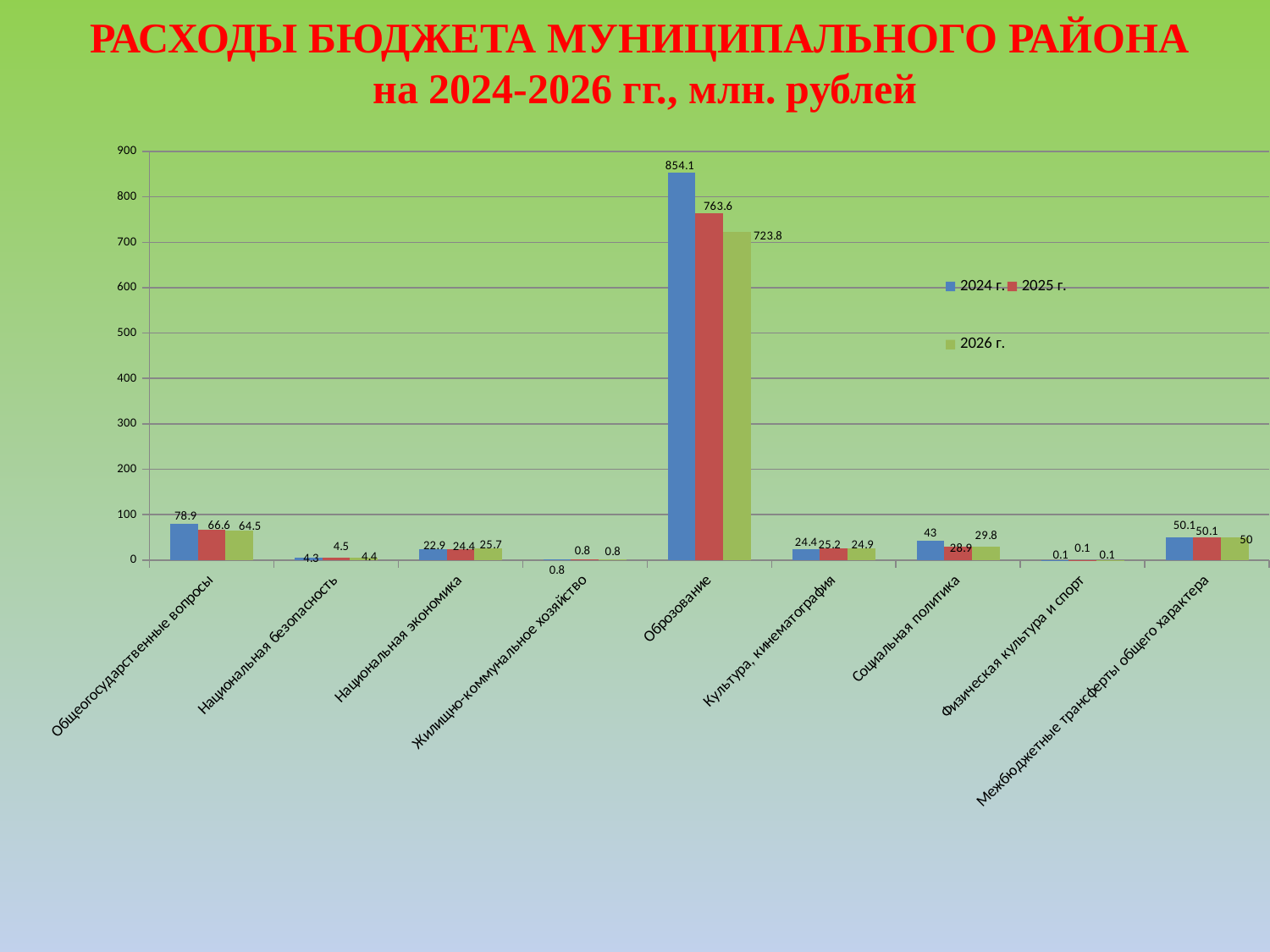
Which category has the highest value in 2025 г.? Образование What is the value for Общегосударственные вопросы in 2026 г.? 64.5 How many categories are shown on the x axis? 9 Which is larger for Национальная экономика: the 2024 г. value or the 2026 г. value? 2026 г. Do the values for Образование rise or fall from 2024 г. to 2026 г.? fall What is the value for Образование in 2024 г.? 854.1 How many series does the legend list? 3 What is the difference between the 2024 г. and 2026 г. values for Образование? 130.3 What is the value for Социальная политика in 2025 г.? 28.9 What type of chart is shown on the slide? bar chart Which category has the lowest value in 2024 г.? Физическая культура и спорт What is the title of the chart? РАСХОДЫ БЮДЖЕТА МУНИЦИПАЛЬНОГО РАЙОНА на 2024-2026 гг., млн. рублей